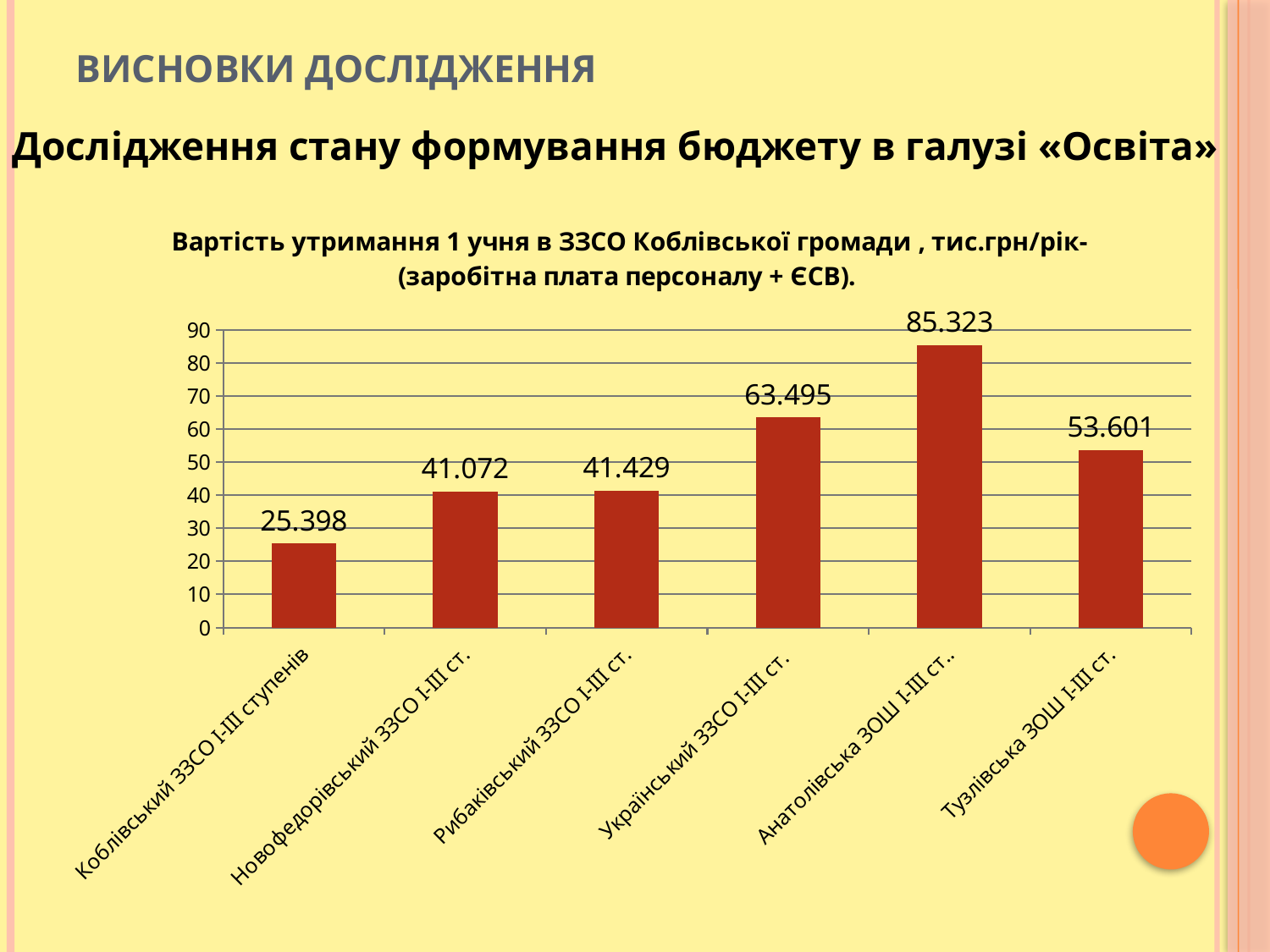
Is the value for Український ЗЗСО І-ІІІ ст. greater or less than 60? greater What kind of chart is shown on the slide? bar chart What is the difference between the values for Анатолівська ЗОШ І-ІІІ ст. and Коблівський ЗЗСО І-ІІІ ступенів? 59.925 What is the value for Коблівський ЗЗСО І-ІІІ ступенів? 25.398 What is the unit of measurement given in the chart title? тис.грн/рік What is the value for Анатолівська ЗОШ І-ІІІ ст.? 85.323 Which school has the highest value? Анатолівська ЗОШ І-ІІІ ст. How many schools are shown on the chart? 6 Which school has the lowest value? Коблівський ЗЗСО І-ІІІ ступенів Which is larger, the value for Український ЗЗСО І-ІІІ ст. or the value for Тузлівська ЗОШ І-ІІІ ст.? Український ЗЗСО І-ІІІ ст. What is the value for Тузлівська ЗОШ І-ІІІ ст.? 53.601 What is the difference between the values for Український ЗЗСО І-ІІІ ст. and Тузлівська ЗОШ І-ІІІ ст.? 9.894